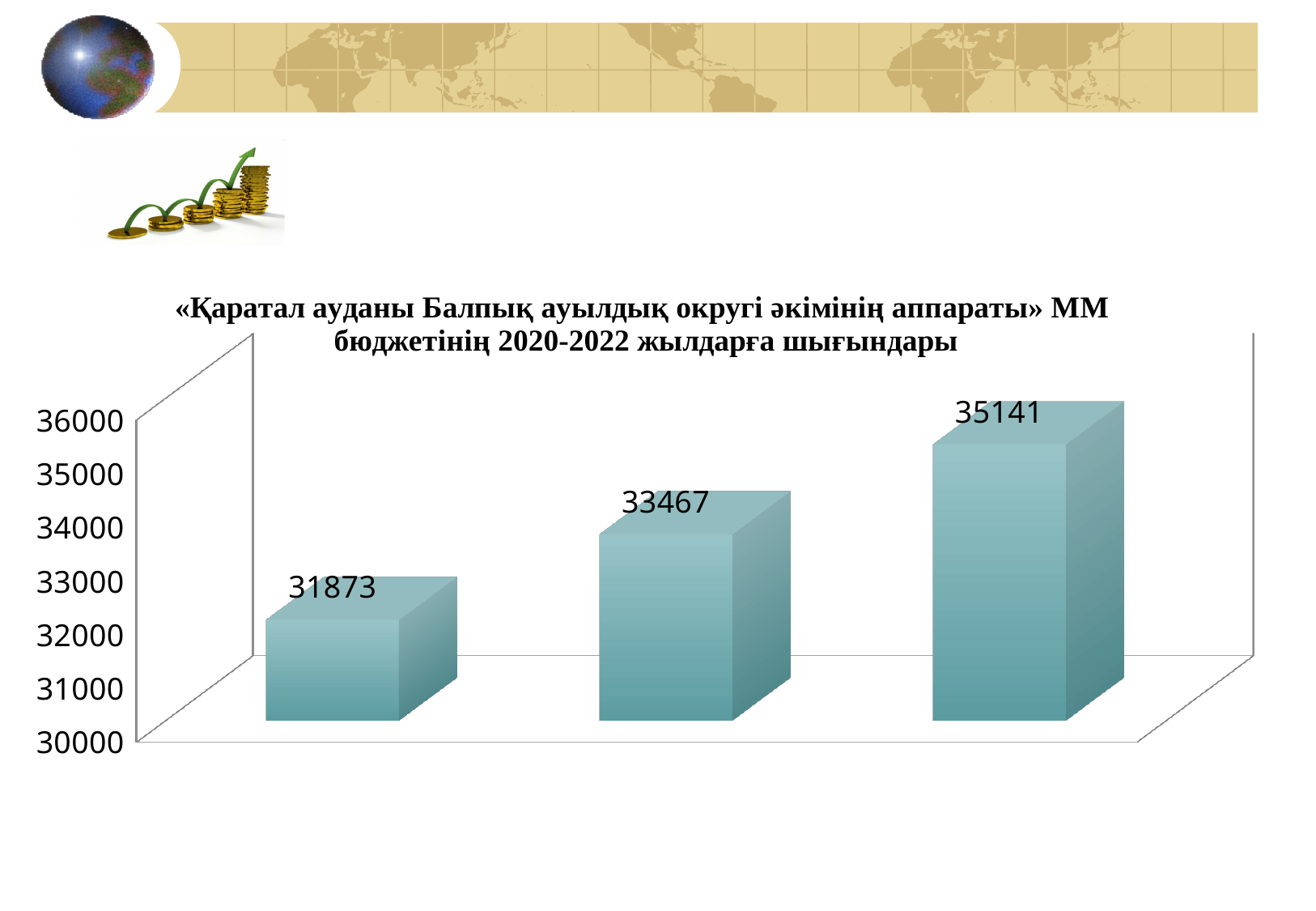
How many bars are plotted in the chart? 3 What is the difference between the middle bar's value and the leftmost bar's value? 1594 What kind of chart is shown on the slide? bar chart What is the difference between the rightmost bar's value and the leftmost bar's value? 3268 Which bar has the lowest value: the leftmost, middle, or rightmost? leftmost What is the value shown on the rightmost bar? 35141 Which is larger, the value of the middle bar or the value of the rightmost bar? rightmost bar Which bar has the highest value: the leftmost, middle, or rightmost? rightmost What is the value shown on the leftmost bar? 31873 What is the value shown on the middle bar? 33467 Is the value of the middle bar greater or less than 34000? less Do the bar values rise or fall from left to right? rise